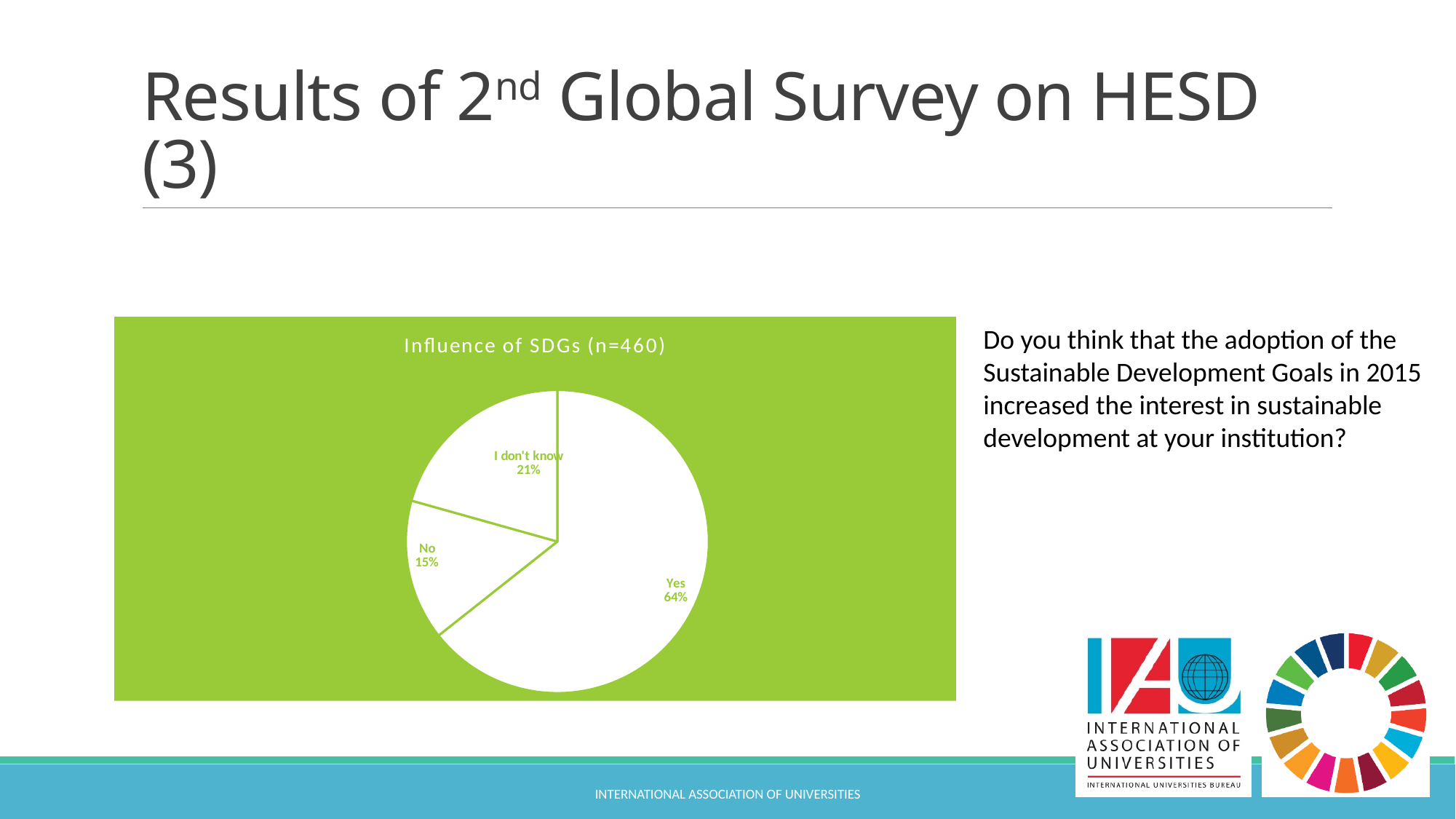
What is the title of the chart? Influence of SDGs (n=460) What percentage of respondents answered "Yes"? 64% Which response has the largest share of the pie? Yes Which is larger, the share for "I don't know" or the share for "No"? I don't know How many slices does the pie chart have? 3 What is the sample size (n) stated in the chart title? 460 What percentage of respondents answered "I don't know"? 21% Which response has the smallest share of the pie? No What is the difference in percentage points between the "Yes" and "No" responses? 49 What percentage of respondents answered "No"? 15% What type of chart is shown on the slide? pie chart What is the difference in percentage points between "I don't know" and "No"? 6